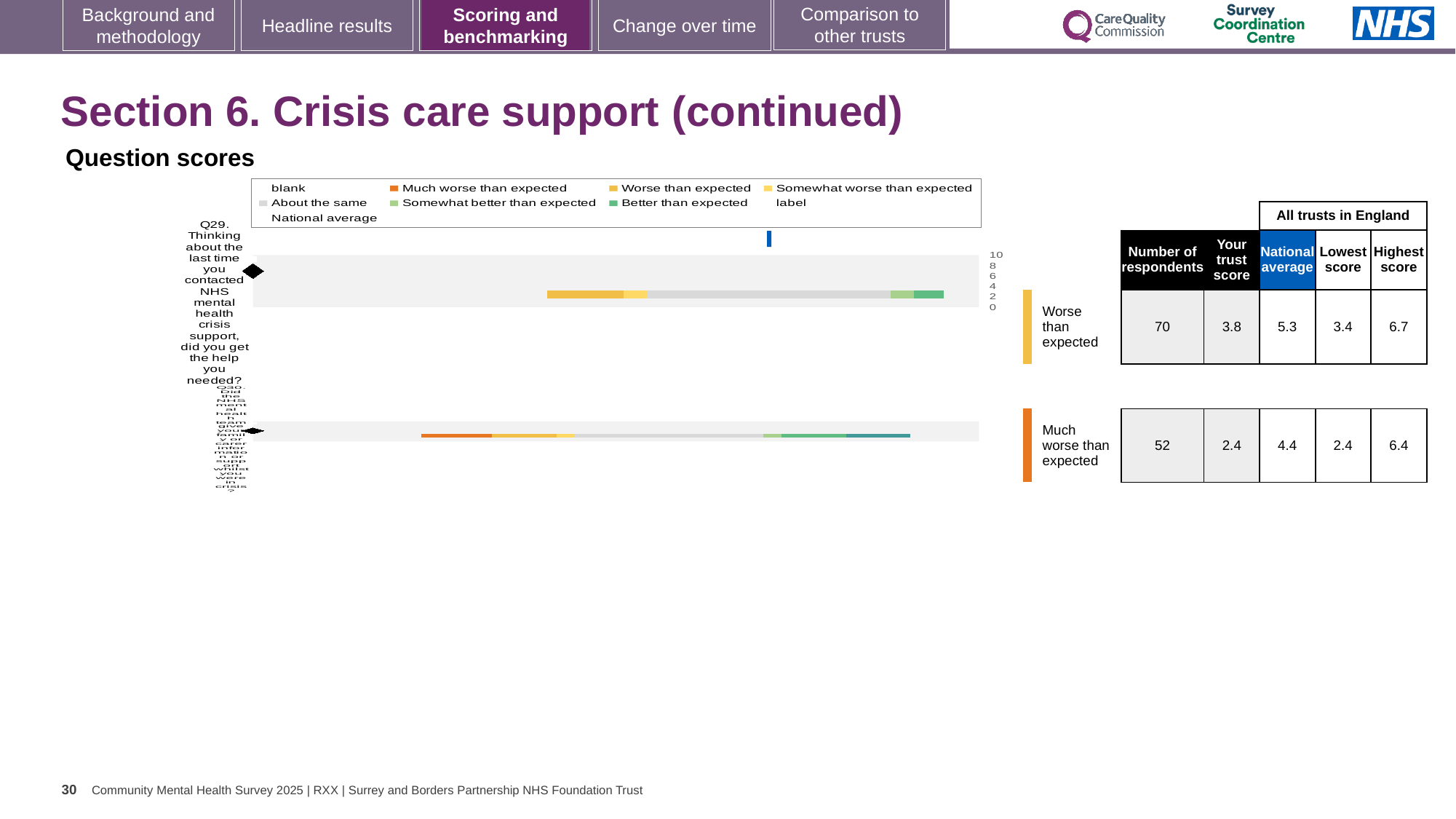
Which benchmark category is Q29 placed in? Worse than expected How many respondents answered Q30? 52 Which benchmark category is Q30 placed in? Much worse than expected What is the trust score for Q30 (information or support for family/carer whilst in crisis)? 2.4 Which question has the higher trust score, Q29 or Q30? Q29 What is the trust score for Q29 (did you get the help you needed)? 3.8 What type of chart is used to show the question scores on this slide? bar chart By how much is the national average for Q29 higher than the trust score for Q29? 1.5 What is the highest score across all trusts in England for Q29? 6.7 What is the difference between the highest and lowest scores across all trusts for Q30? 4.0 How many questions are plotted in the question scores chart? 2 What is the national average score for Q29? 5.3